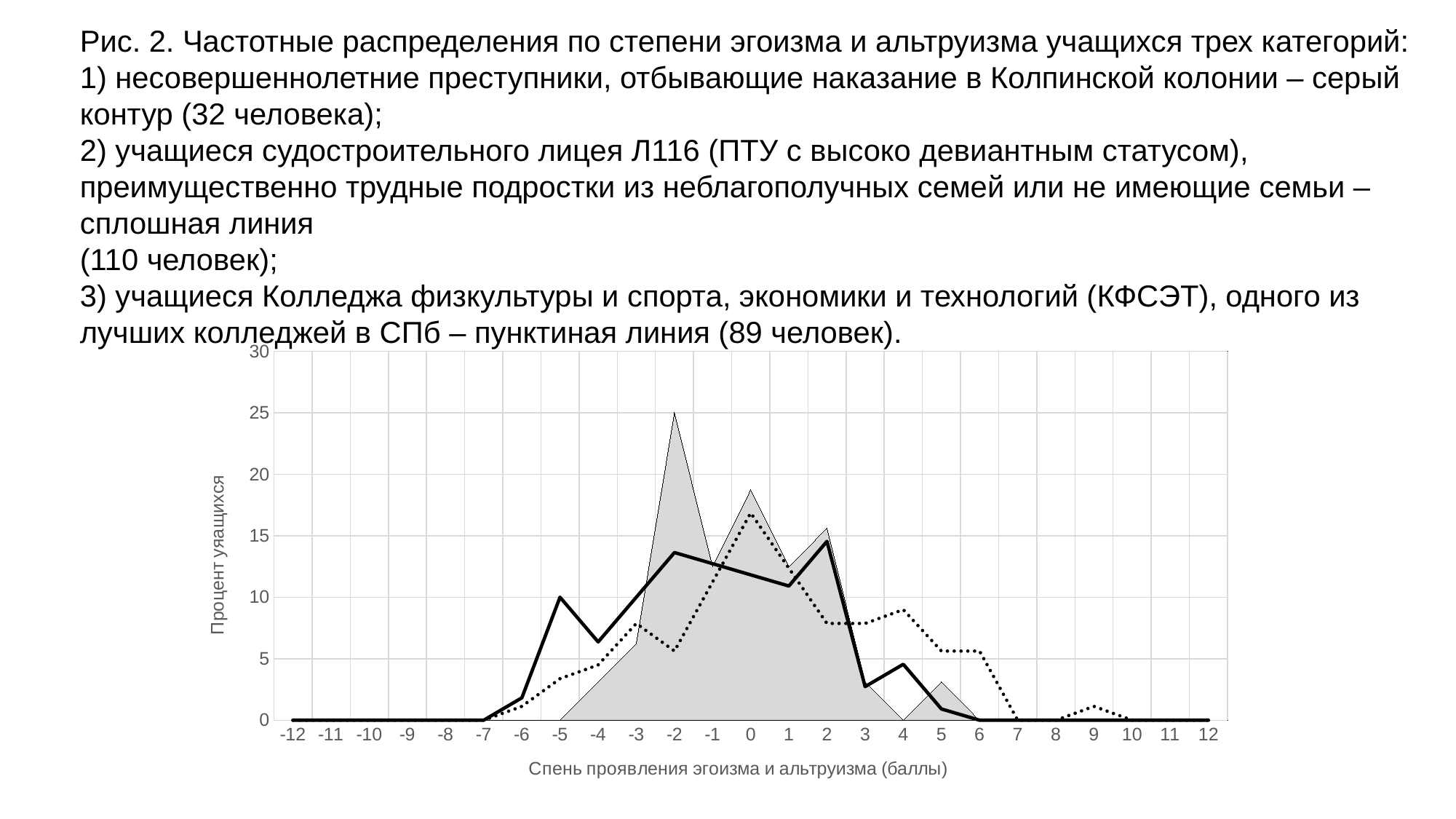
At which x-axis value does the dotted line (КФСЭТ) reach its highest point? 0 Does the dotted line (КФСЭТ) rise or fall between x = 4 and x = 7? fall What is the title of the x axis of the chart? Спень проявления эгоизма и альтруизма (баллы) How many tick values are shown on the x axis of the chart? 25 Is the value of the solid line (Л116) at x = -2 greater or less than 10? greater How many series are plotted on the chart? 3 Is the value of the dotted line (КФСЭТ) at x = 0 greater or less than 15? greater Is the value of the dotted line (КФСЭТ) at x = 4 greater or less than 5? greater At x = -2, which is larger: the grey filled area (Колпинская колония) or the solid line (Л116)? the grey filled area At x = 0, which is larger: the dotted line (КФСЭТ) or the solid line (Л116)? the dotted line At which x-axis value does the grey filled area (Колпинская колония) reach its highest point? -2